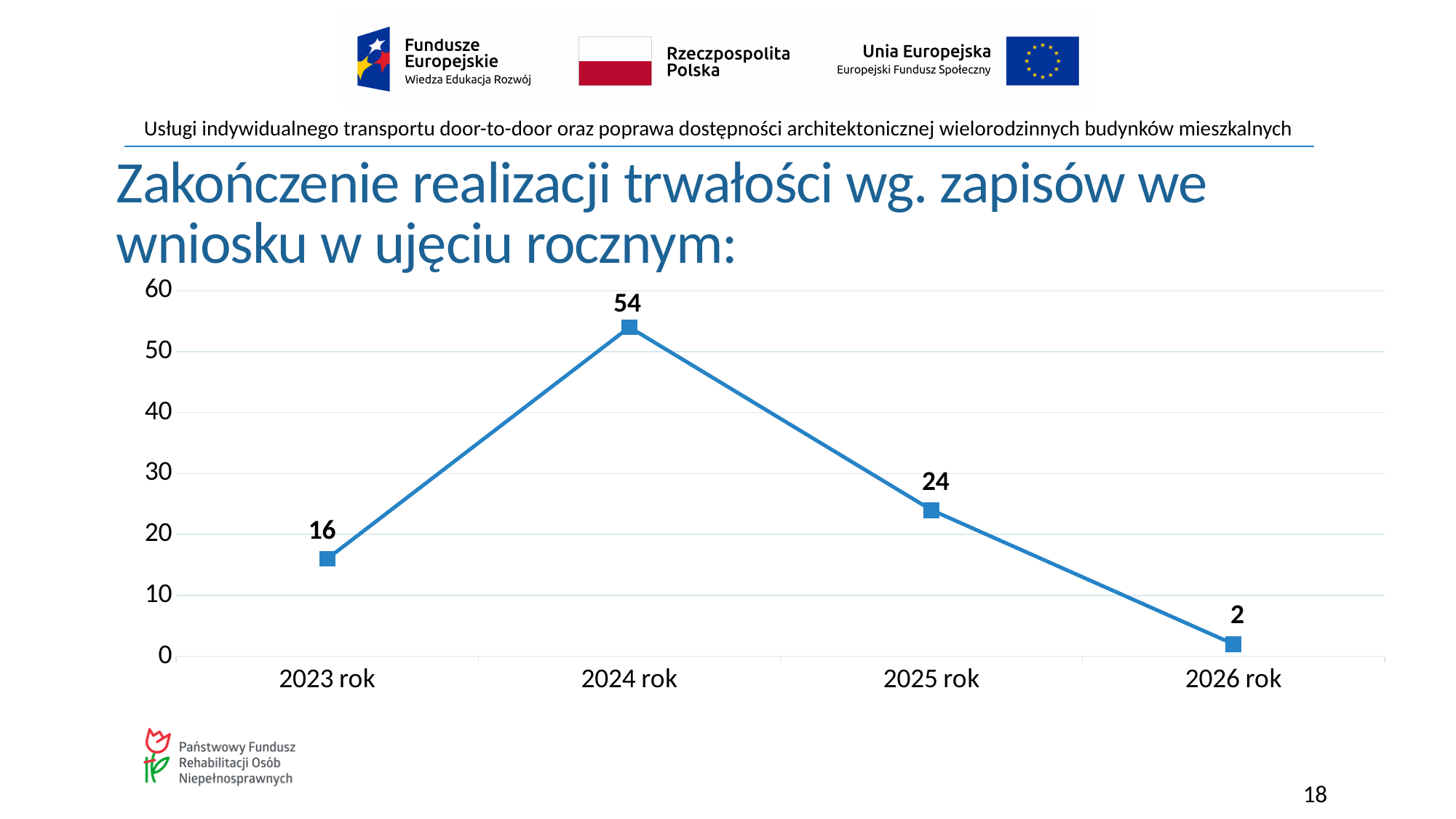
Is the value for 2024 rok greater or less than 50? greater What is the value for 2024 rok? 54 What is the difference between the values for 2024 rok and 2025 rok? 30 How many years are plotted on the chart? 4 Which is larger, the value for 2023 rok or the value for 2025 rok? 2025 rok What kind of chart is shown on the slide? line chart Which year has the highest value? 2024 rok Do the values rise or fall from 2024 rok to 2026 rok? fall Which year has the lowest value? 2026 rok What is the value for 2023 rok? 16 What is the value for 2026 rok? 2 What is the value for 2025 rok? 24